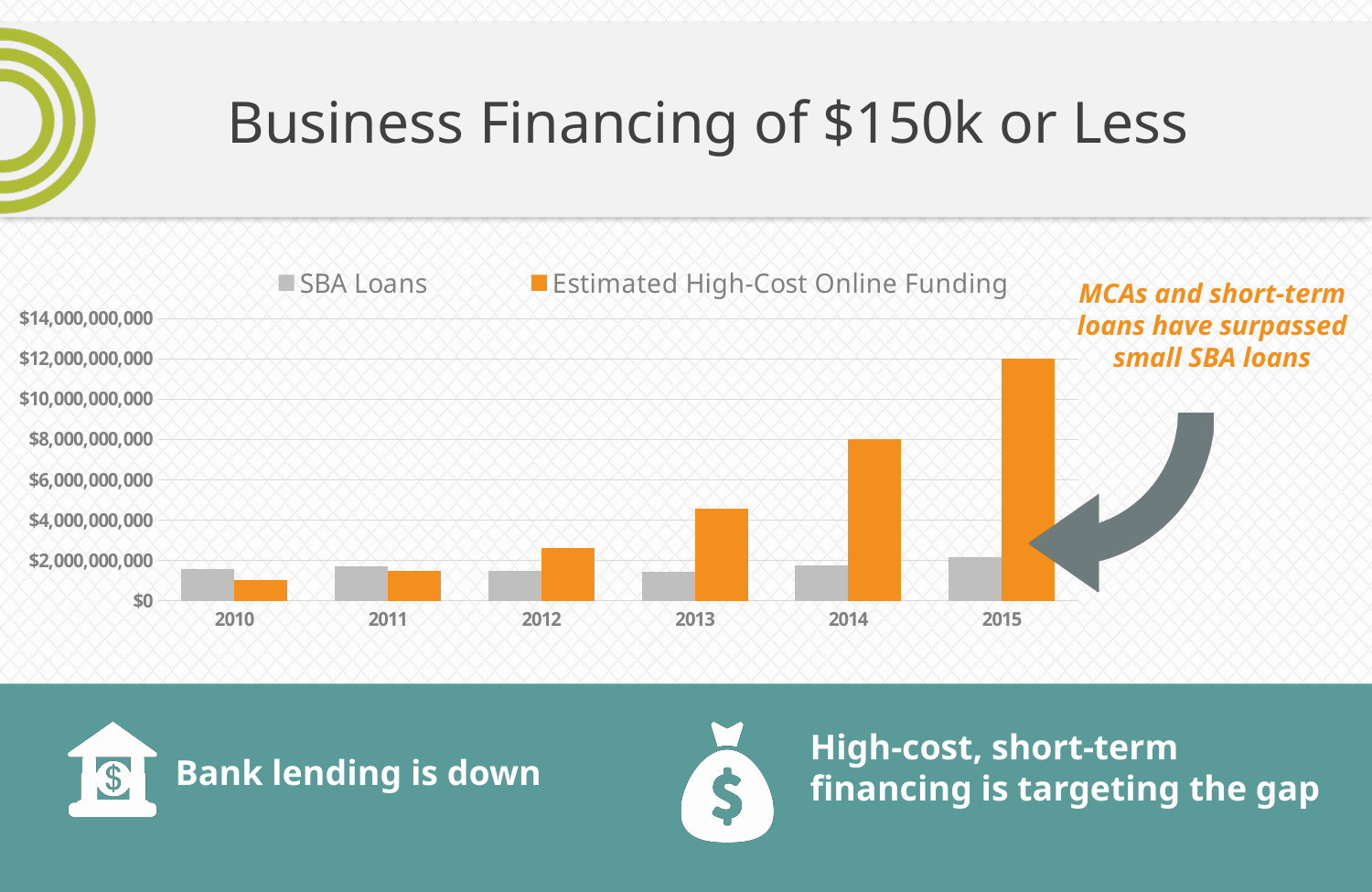
What kind of chart is shown on the slide? bar chart Is the value for SBA Loans in 2015 greater or less than $4,000,000,000? less How many series does the chart legend list? 2 What is the value of Estimated High-Cost Online Funding in 2015? $12,000,000,000 How many years are shown on the x axis of the chart? 6 In 2015, which is larger: SBA Loans or Estimated High-Cost Online Funding? Estimated High-Cost Online Funding Is the value for Estimated High-Cost Online Funding in 2013 greater or less than $4,000,000,000? greater Which colour represents SBA Loans in the chart? gray Which year has the highest value for Estimated High-Cost Online Funding? 2015 Which year has the lowest value for Estimated High-Cost Online Funding? 2010 Do the values for Estimated High-Cost Online Funding rise or fall from 2010 to 2015? rise What is the value of Estimated High-Cost Online Funding in 2014? $8,000,000,000